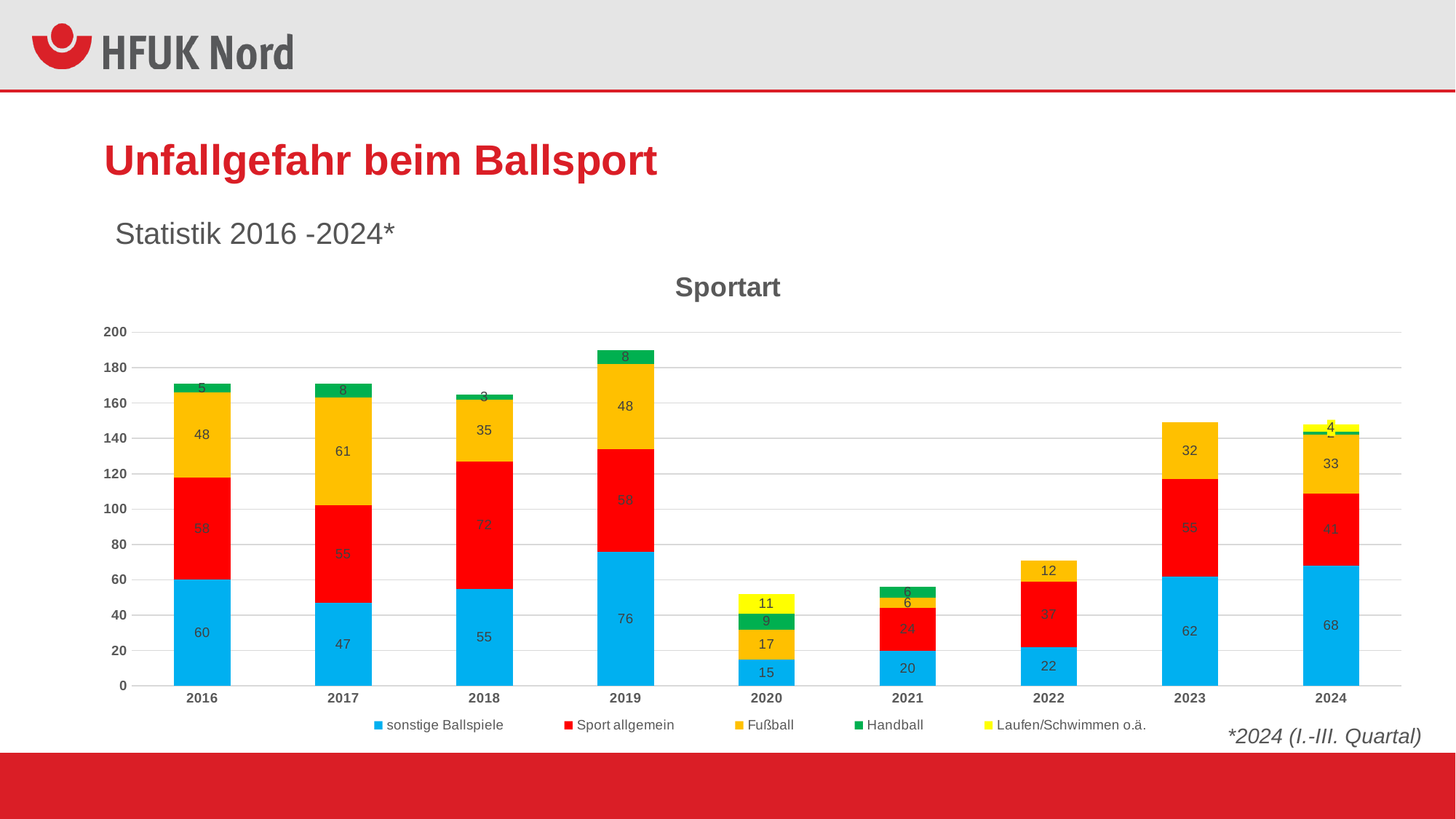
What is the value for sonstige Ballspiele in 2019? 76 Which year has the lowest value for sonstige Ballspiele? 2020 What is the difference between the Fußball values for 2019 and 2018? 13 Which is larger, the sonstige Ballspiele value for 2023 or for 2024? 2024 What is the value for Sport allgemein in 2018? 72 Is the total stacked bar for 2023 greater or less than 140? greater What is the value for Laufen/Schwimmen o.ä. in 2020? 11 What is the total of the stacked bar for 2022? 71 What is the total of the stacked bar for 2016? 171 Which year has the highest total stacked bar? 2019 Which year has the highest value for Fußball? 2017 What is the value for Fußball in 2017? 61